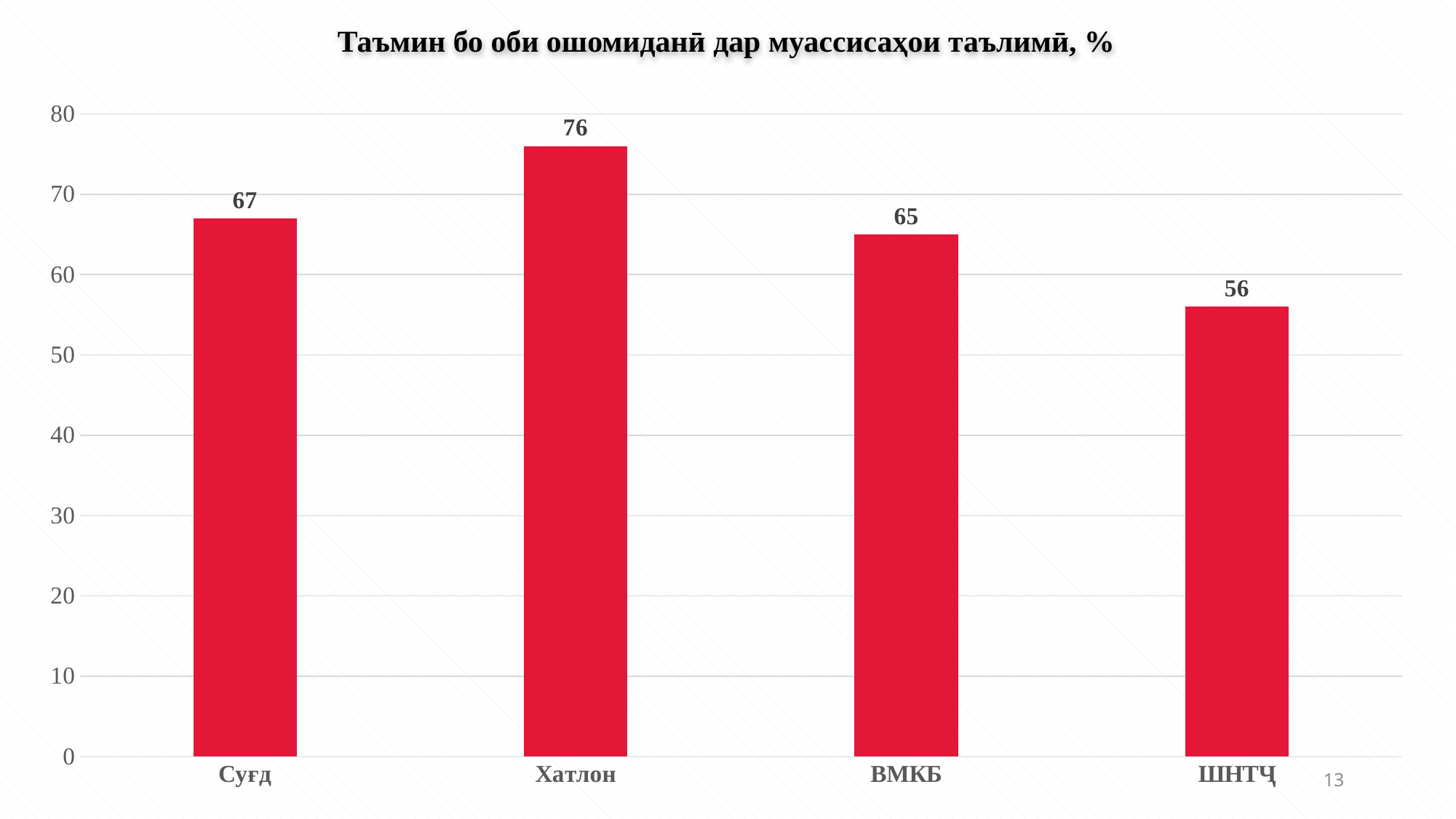
Which category has the lowest value? ШНТҶ What is the value for Суғд? 67 What kind of chart is shown on the slide? bar chart What is the value for ВМКБ? 65 Which is larger, the value for Суғд or the value for Хатлон? Хатлон Is the value for ВМКБ greater or less than 60? greater What is the value for ШНТҶ? 56 What is the difference between the values for Хатлон and ШНТҶ? 20 How many categories are shown on the chart? 4 What is the value for Хатлон? 76 What is the difference between the values for Суғд and ВМКБ? 2 Which category has the highest value? Хатлон